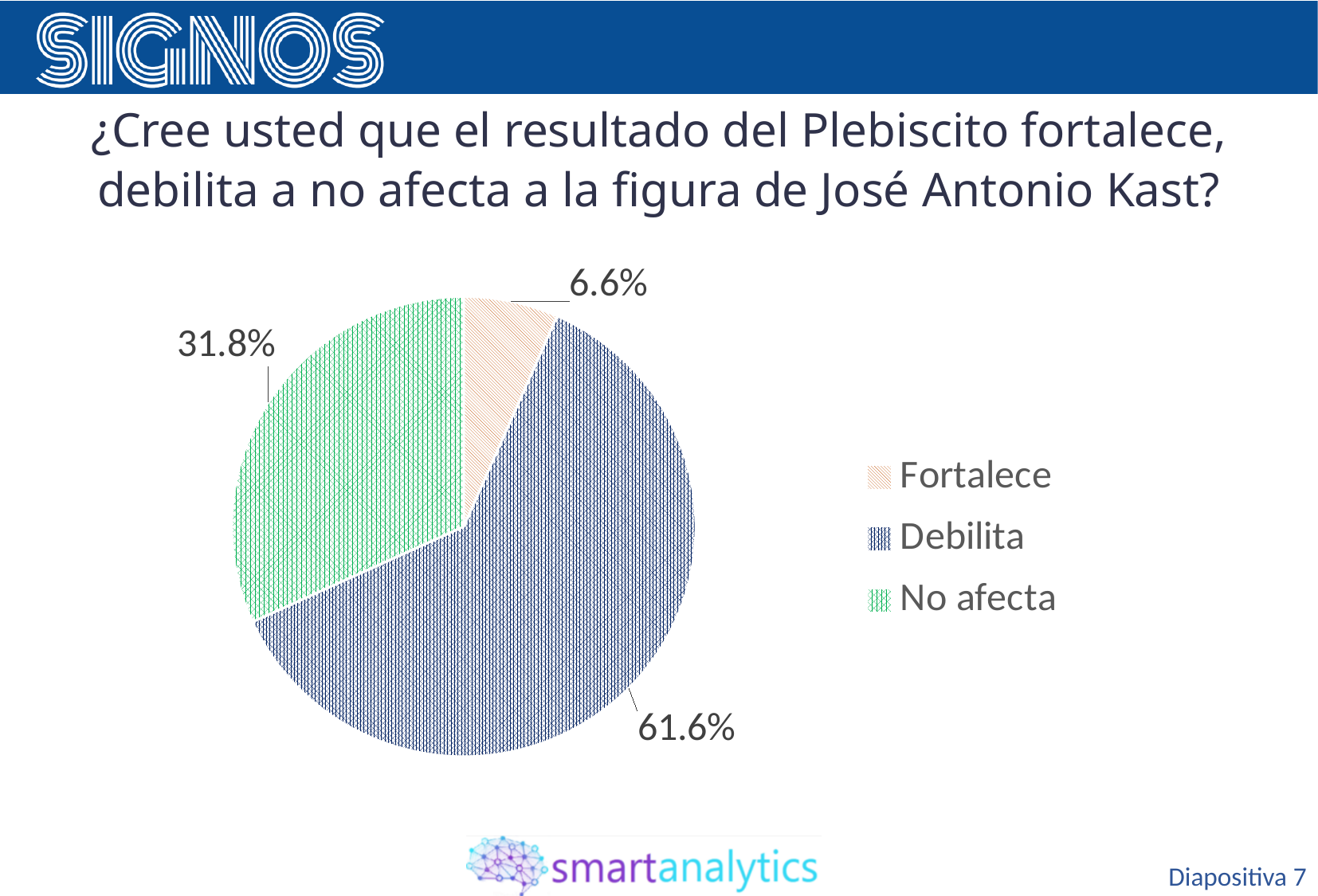
What kind of chart is shown on the slide? Pie chart Which is larger, the share for "No afecta" or the share for "Fortalece"? No afecta What percentage of respondents answered "Fortalece"? 6.6% What percentage of respondents answered "Debilita"? 61.6% Which response has the smallest share of the pie? Fortalece How many slices does the pie chart have? 3 Which legend entry is shown with a green pattern? No afecta What is the difference in percentage points between "Debilita" and "No afecta"? 29.8 Which response has the largest share of the pie? Debilita How many entries does the legend list? 3 What is the difference in percentage points between "No afecta" and "Fortalece"? 25.2 What percentage of respondents answered "No afecta"? 31.8%